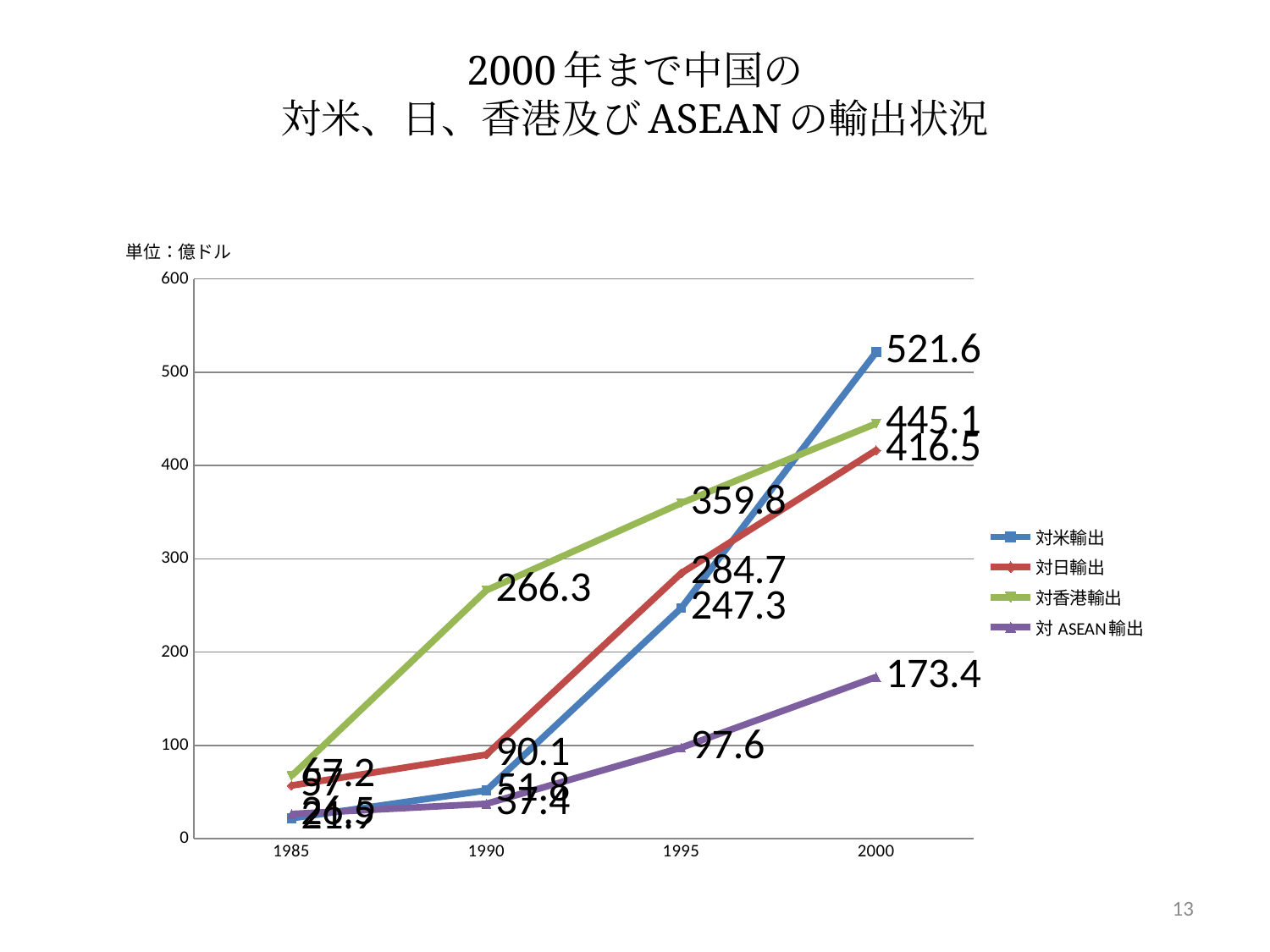
How many series does the legend list? 4 What is the value of 対日輸出 in 1995? 284.7 In 1995, which is larger: 対日輸出 or 対米輸出? 対日輸出 How many years are shown on the x axis? 4 Does 対米輸出 rise or fall from 1985 to 2000? rise What is the value of 対米輸出 in 2000? 521.6 What is the value of 対ASEAN輸出 in 2000? 173.4 Which series has the lowest value in 1995? 対ASEAN輸出 Which series has the highest value in 2000? 対米輸出 What type of chart is shown on the slide? line chart What is the value of 対香港輸出 in 1995? 359.8 What is the difference between 対香港輸出 and 対日輸出 in 2000? 28.6